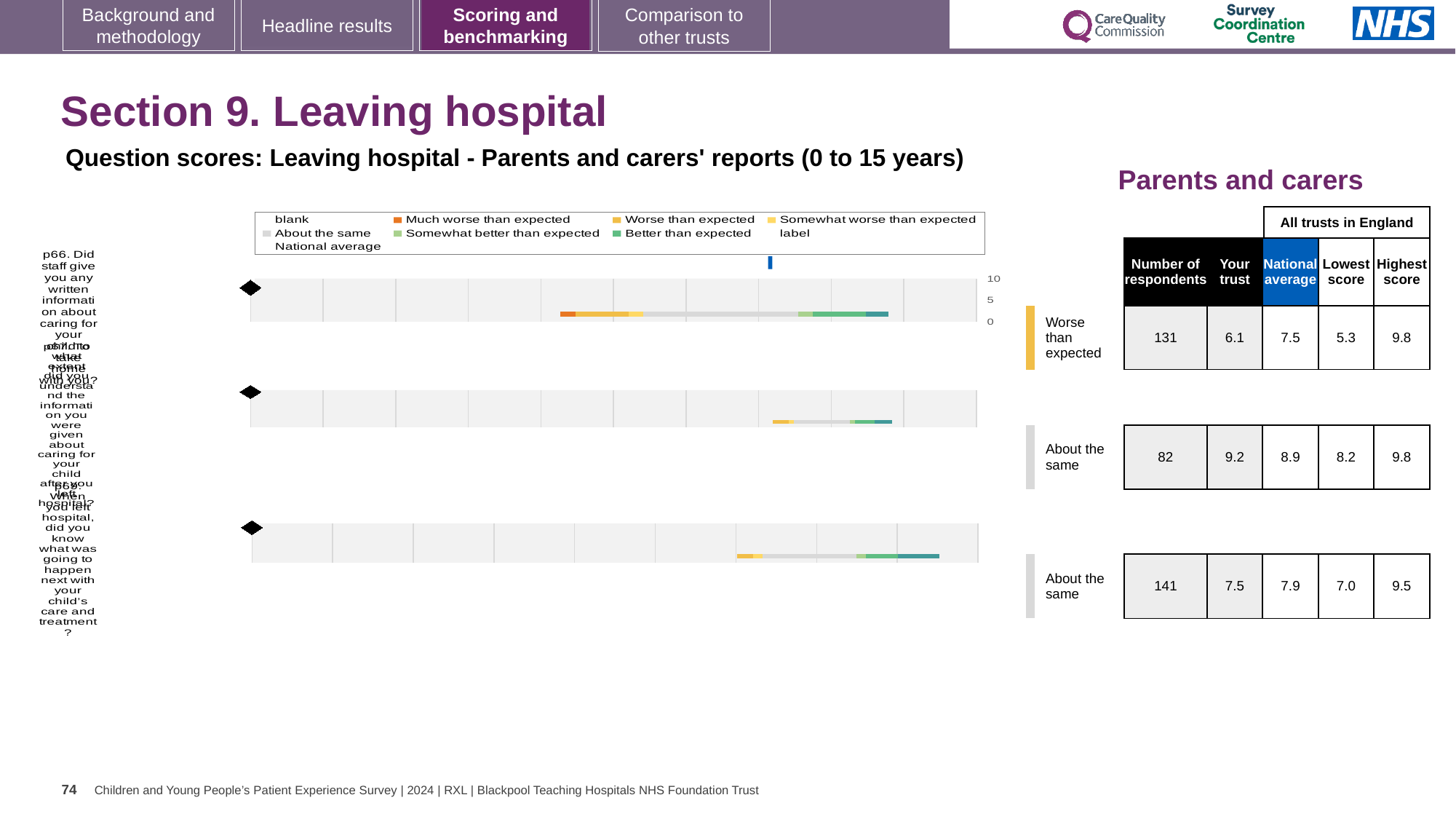
For the first (top) chart row, what is the 'Your trust' score shown in the table? 6.1 What kind of chart is used for the three question rows on the slide? bar chart How many entries does the shared legend above the charts list? 9 In the legend above the charts, which entry is shown in grey? About the same For the third (bottom) chart row, is the 'Your trust' score larger or smaller than the national average? smaller For the third (bottom) chart row, what is the number of respondents shown in the table? 141 For the second (middle) chart row, what is the 'Your trust' score shown in the table? 9.2 In the legend above the charts, which colour represents 'Much worse than expected'? orange For the first (top) chart row, what is the national average shown in the table? 7.5 How many question charts (bar rows) are shown on the slide? 3 Which chart row has the highest 'Your trust' score in the table: the top, middle or bottom? middle For the second (middle) chart row, what is the difference between the 'Your trust' score and the national average? 0.3